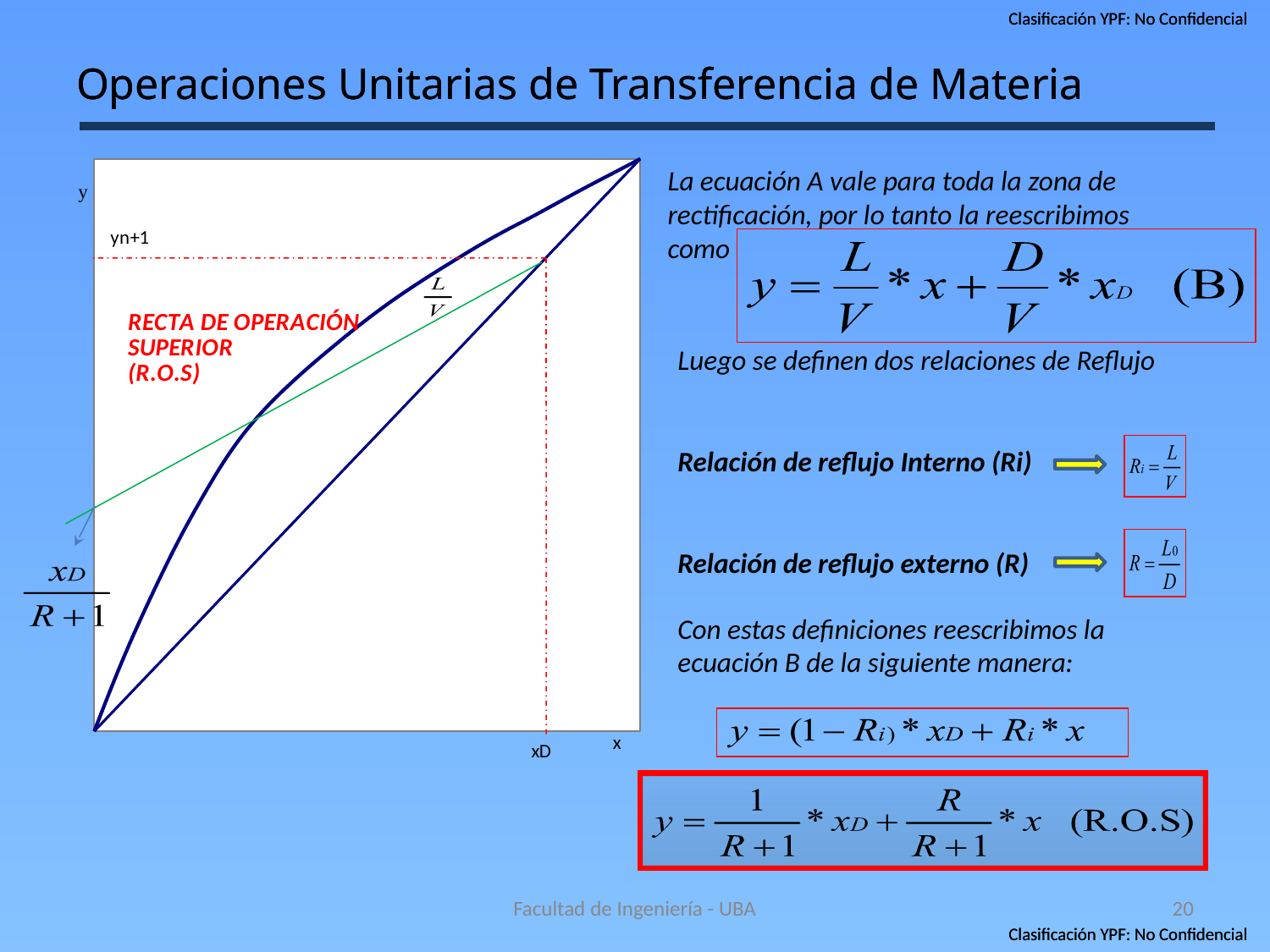
What is the label on the horizontal axis of the chart? x What kind of chart is shown on the left of the slide? line chart Does the green line labelled L/V rise or fall as x increases? rises What name is given in red text to the green line in the chart? RECTA DE OPERACIÓN SUPERIOR (R.O.S) Does the thick curved line rise or fall as x increases? rises How many lines are plotted inside the chart area (excluding the dashed guide lines)? 3